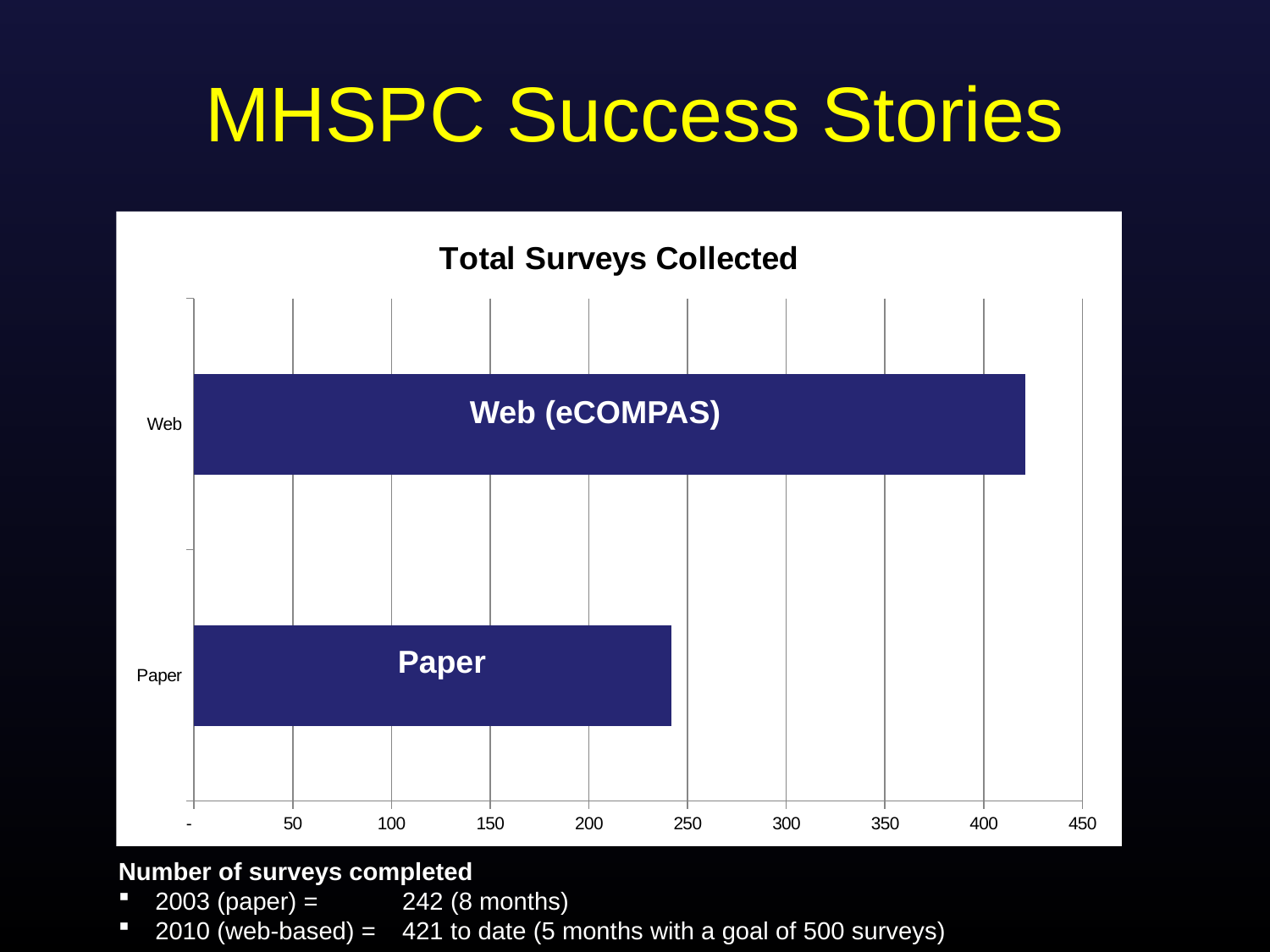
According to the slide, how many surveys were collected via the web (eCOMPAS)? 421 Is the value for Paper greater or less than 250? less According to the slide, how many surveys were collected on paper? 242 What is the title of the chart? Total Surveys Collected What is the difference between the number of web surveys and paper surveys stated on the slide? 179 Is the value for Paper greater or less than 200? greater Which category has the lowest value in the chart? Paper Is the value for Web greater or less than 400? greater Which is larger, the value for Web or the value for Paper? Web What type of chart is shown on the slide? bar chart Which category has the highest value in the chart? Web (eCOMPAS) How many categories are plotted in the chart? 2